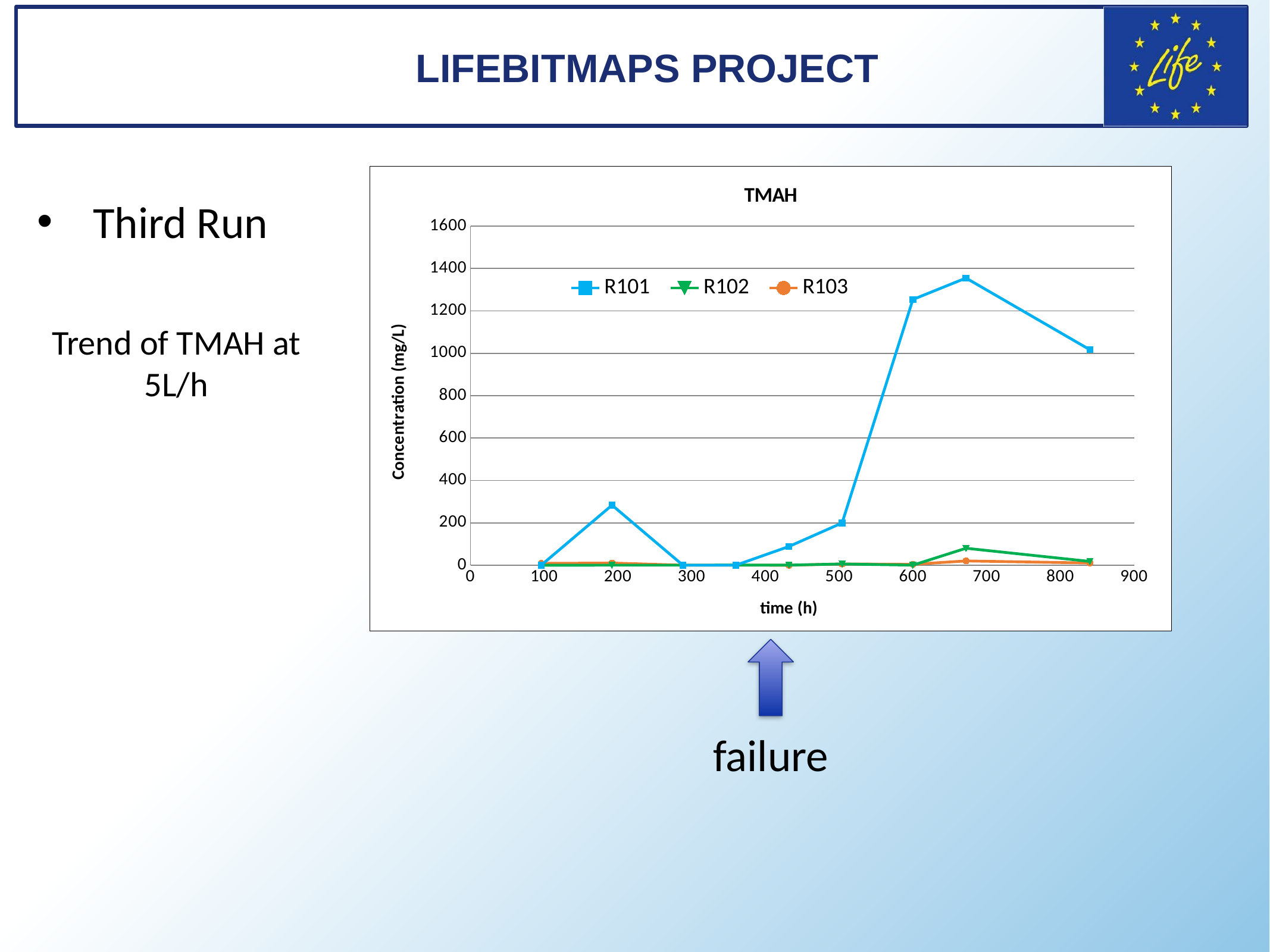
What type of chart is shown on the slide? line chart Is the value of R101 at about 200 h greater or less than 400? less How many data points are plotted for the R101 series? 9 At about 670 h, which series has the larger value, R101 or R102? R101 How many series does the legend of the chart list? 3 Is the value of R101 at about 600 h greater or less than 1000? greater What is the title of the chart? TMAH Is the last plotted value of R101 (around 840 h) greater or less than 1200? less What is the label of the y axis of the chart? Concentration (mg/L) Which series reaches the highest concentration in the chart? R101 Does the R101 line rise or fall between about 670 h and 840 h? fall